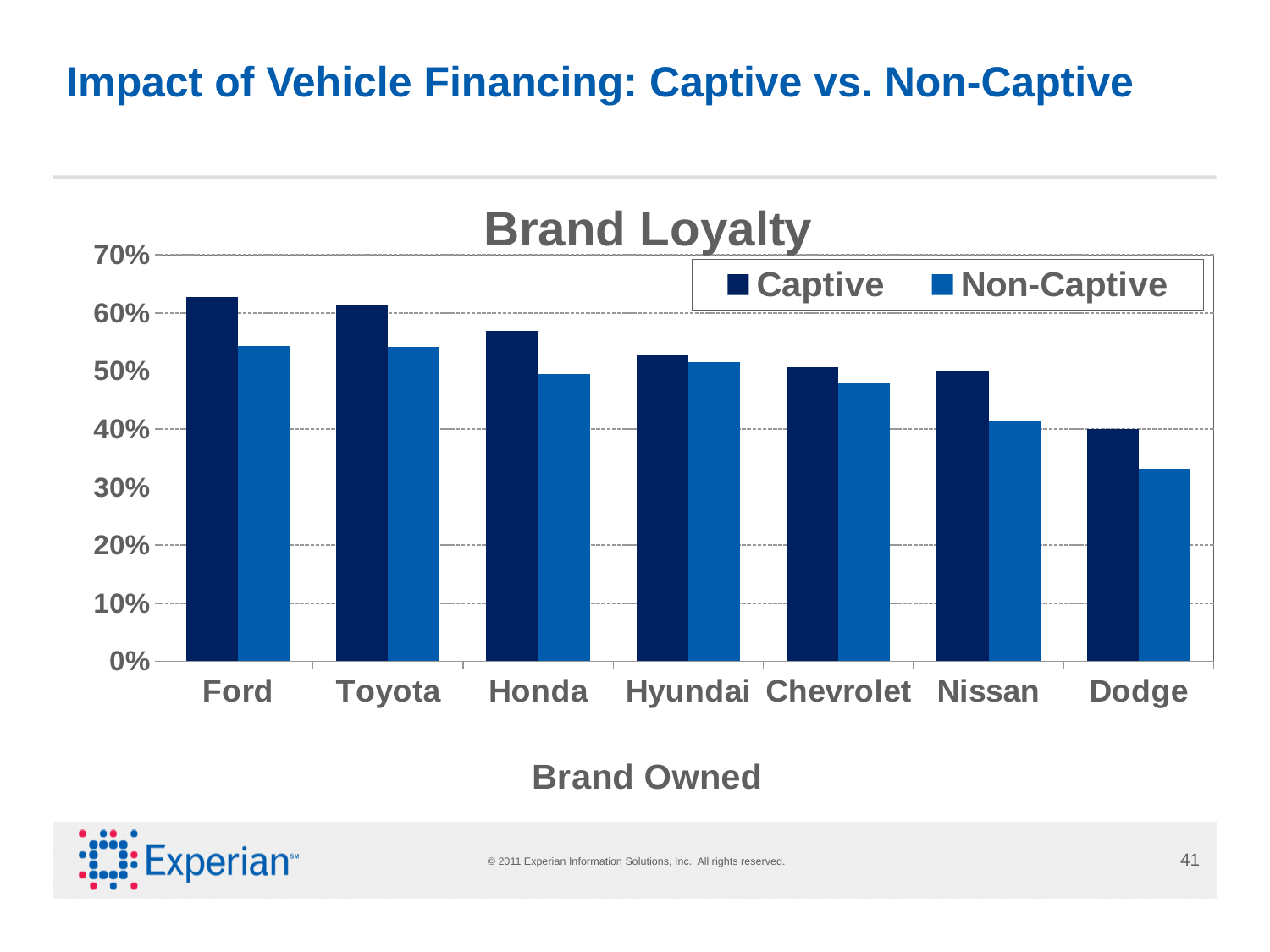
Which brand has the lowest Captive brand loyalty? Dodge Is the Captive value for Ford greater or less than 60%? greater How many series does the legend of the Brand Loyalty chart list? 2 Is the Non-Captive value for Dodge greater or less than 40%? less What kind of chart is shown on the slide? bar chart Do the Captive values rise or fall moving from Ford to Dodge along the x axis? fall For Nissan, which is larger: the Captive value or the Non-Captive value? Captive How many brands are shown on the x axis of the Brand Loyalty chart? 7 Which brand has the highest Captive brand loyalty? Ford Is the Captive value for Honda greater or less than 50%? greater What is the x-axis title of the Brand Loyalty chart? Brand Owned Which brand has the lowest Non-Captive brand loyalty? Dodge